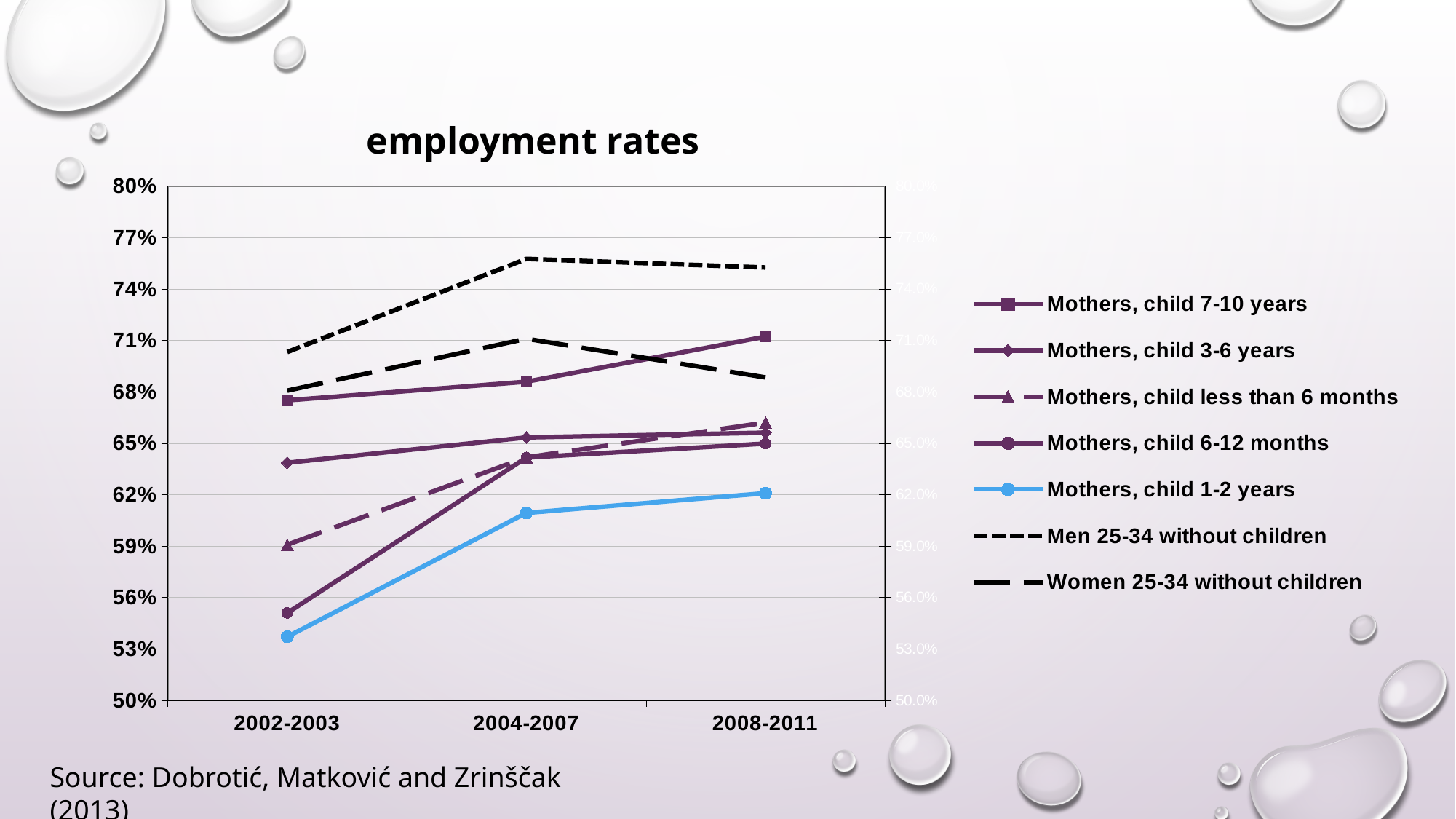
Is the value for Mothers, child 1-2 years in 2002-2003 greater or less than 56%? less Does the employment rate for Mothers, child 1-2 years rise or fall from 2002-2003 to 2008-2011? rise How many periods are shown on the x axis? 3 In 2008-2011, which is higher: Mothers, child 7-10 years or Women 25-34 without children? Mothers, child 7-10 years Which series has the lowest employment rate in 2002-2003? Mothers, child 1-2 years How many series does the legend list? 7 What is the title of the chart? employment rates What kind of chart is shown on the slide? line chart Is the value for Men 25-34 without children in 2004-2007 greater or less than 74%? greater Does the employment rate for Women 25-34 without children rise or fall from 2004-2007 to 2008-2011? fall Is the value for Mothers, child less than 6 months in 2002-2003 greater or less than 62%? less Which series has the highest employment rate in 2008-2011? Men 25-34 without children